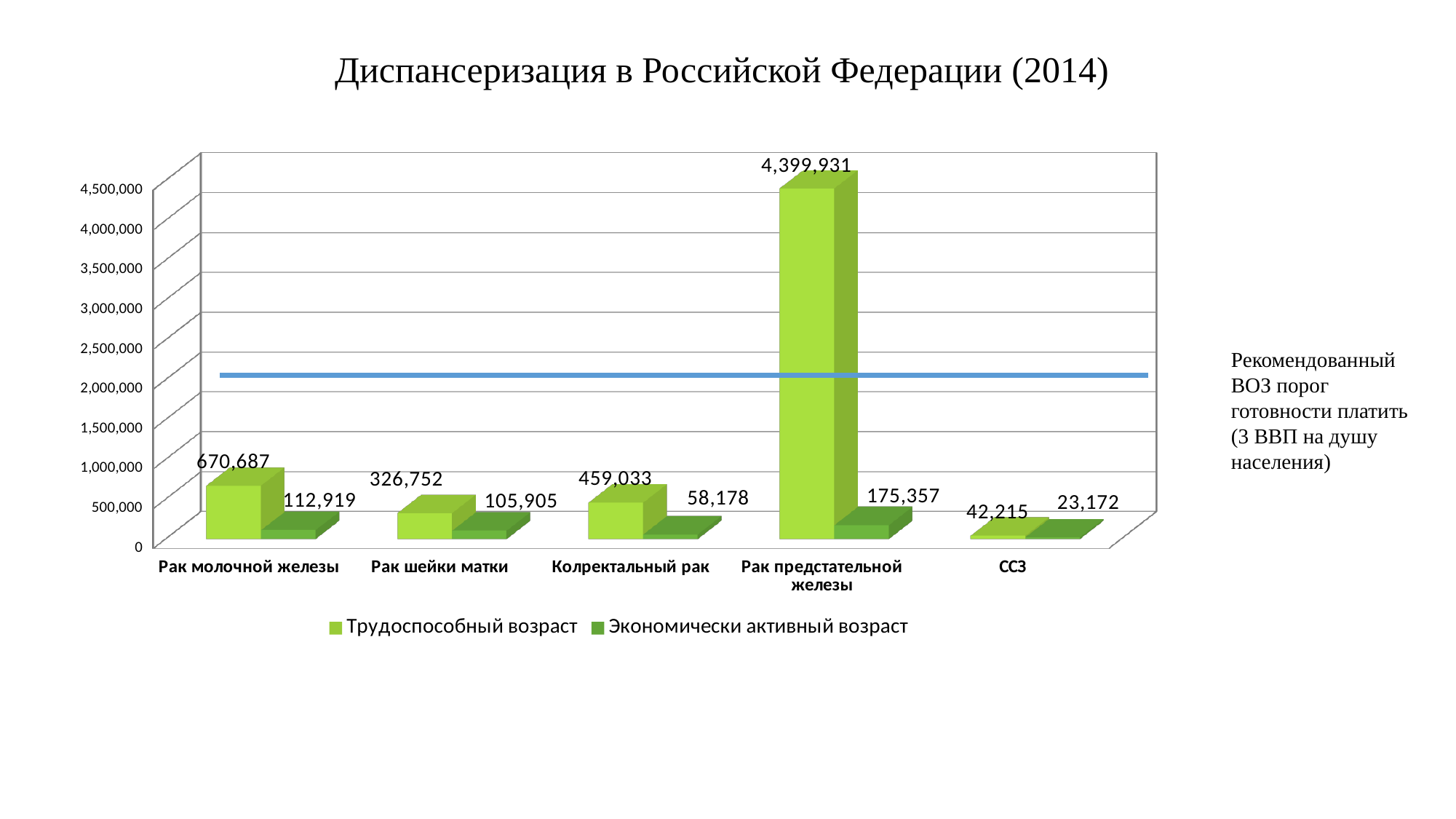
Which category has the highest value in the Трудоспособный возраст series? Рак предстательной железы What kind of chart is shown on the slide? Bar chart Which is larger in the Трудоспособный возраст series: Рак молочной железы or Колректальный рак? Рак молочной железы How many series does the legend list? 2 What is the difference between the Трудоспособный возраст and Экономически активный возраст values for Рак шейки матки? 220,847 Which category has the lowest value in the Экономически активный возраст series? ССЗ What is the value for ССЗ in the Трудоспособный возраст series? 42,215 What is the value for Рак предстательной железы in the Трудоспособный возраст series? 4,399,931 What is the title of the chart? Диспансеризация в Российской Федерации (2014) What is the value for Рак молочной железы in the Экономически активный возраст series? 112,919 What is the value for Колректальный рак in the Экономически активный возраст series? 58,178 How many categories are shown on the x axis? 5